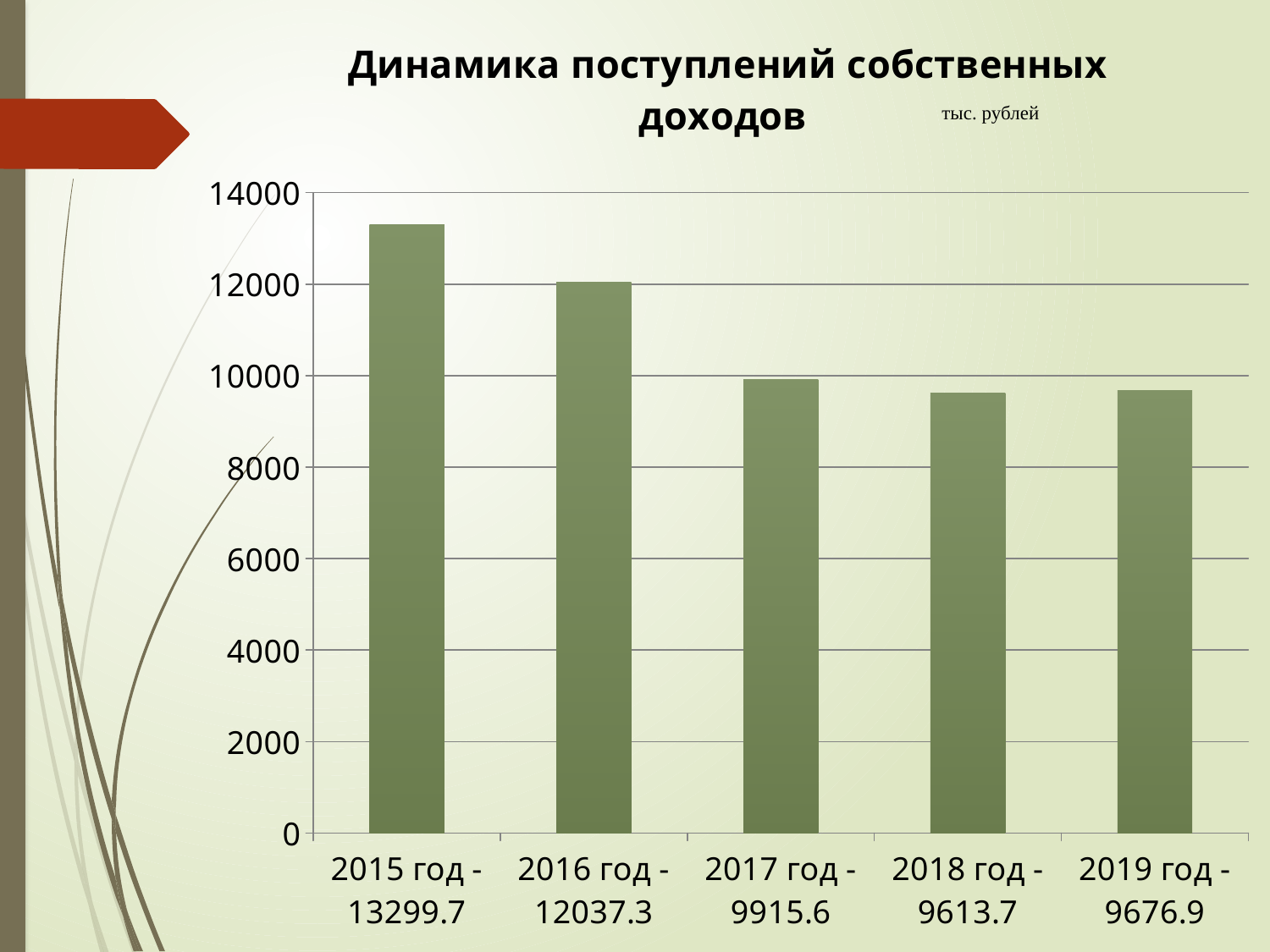
Which is larger, the value for 2016 год or the value for 2017 год? 2016 год What is the difference between the values for 2015 год and 2016 год? 1262.4 What is the value for 2015 год? 13299.7 What is the value for 2019 год? 9676.9 Which year has the lowest value? 2018 год What is the value for 2017 год? 9915.6 Which year has the highest value? 2015 год What kind of chart is shown on the slide? bar chart How many years are shown on the chart? 5 What is the difference between the values for 2019 год and 2018 год? 63.2 Do the values generally rise or fall from 2015 год to 2018 год? fall Is the value for 2016 год greater or less than 12000? greater